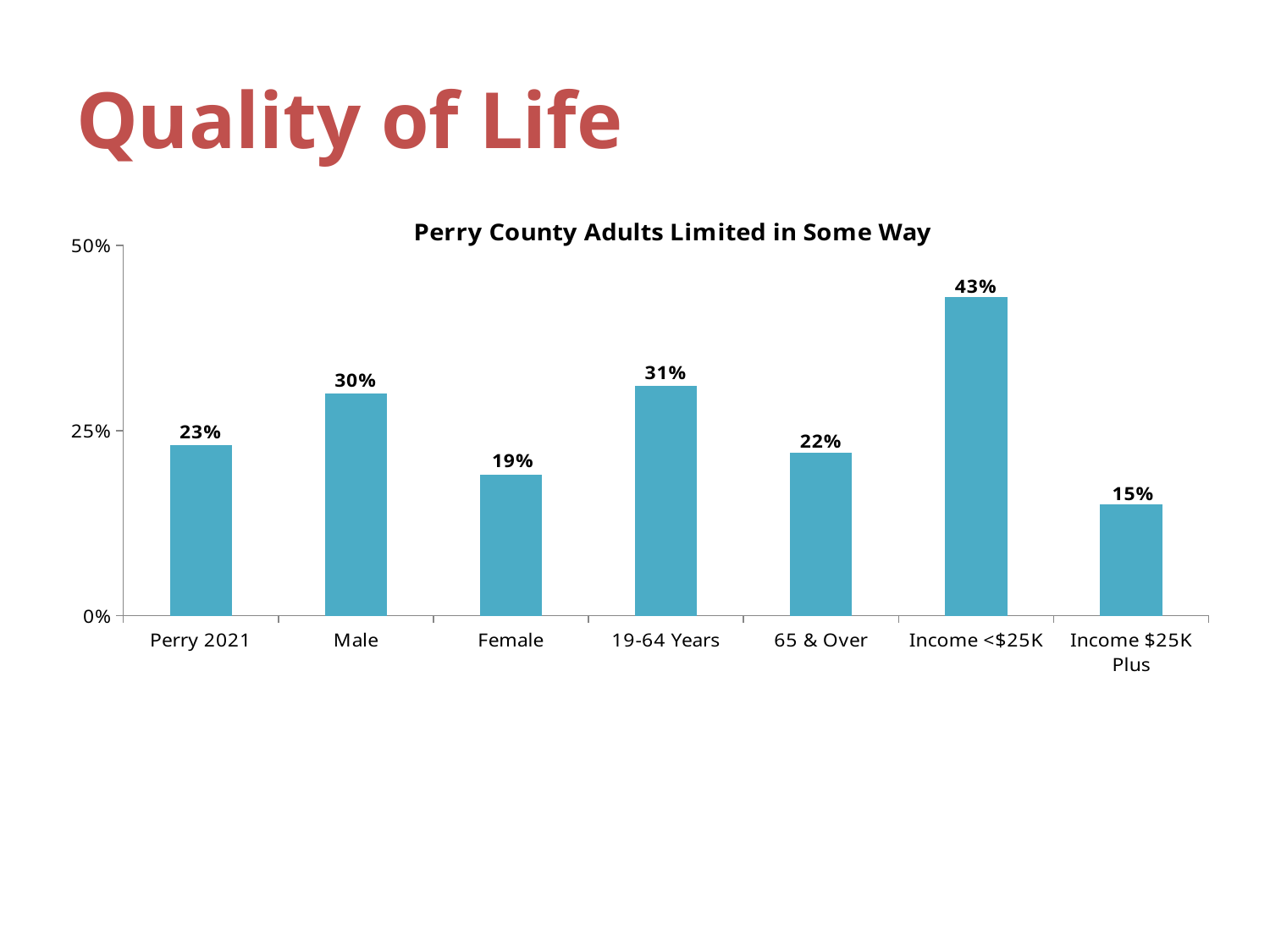
Is the value for Female greater or less than 25%? less Which category has the highest value? Income <$25K What kind of chart is shown on the slide? bar chart What is the difference between the values for Income <$25K and Income $25K Plus? 28% How many categories are shown on the x axis? 7 Which category has the lowest value? Income $25K Plus What is the value for Perry 2021? 23% What is the value for Income <$25K? 43% What is the title of the chart? Perry County Adults Limited in Some Way Which is larger, the value for 19-64 Years or the value for 65 & Over? 19-64 Years What is the value for Male in the chart? 30% What is the difference between the values for Male and Female? 11%